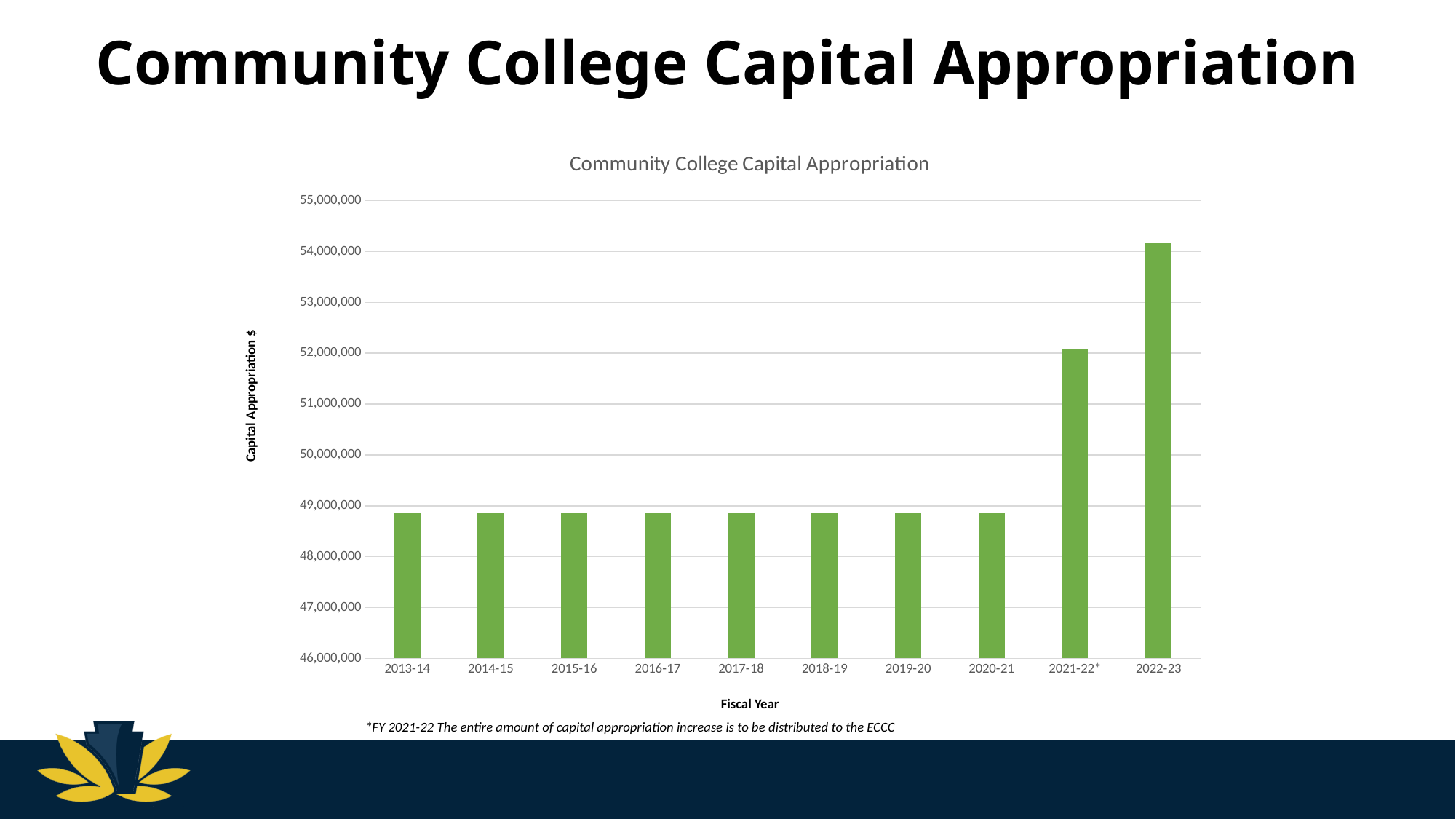
Is the value for 2020-21 greater or less than 50,000,000? less Is the value for 2021-22* greater or less than 51,000,000? greater What kind of chart is shown on the slide? bar chart How many fiscal years are plotted on the chart? 10 Which fiscal year has the highest capital appropriation? 2022-23 Is the value for 2022-23 greater or less than 53,000,000? greater Do the values rise or fall from 2020-21 to 2022-23? rise What is the label on the y axis of the chart? Capital Appropriation $ Which is larger, the capital appropriation for 2020-21 or for 2021-22*? 2021-22* Which is larger, the capital appropriation for 2021-22* or for 2022-23? 2022-23 What is the label on the x axis of the chart? Fiscal Year